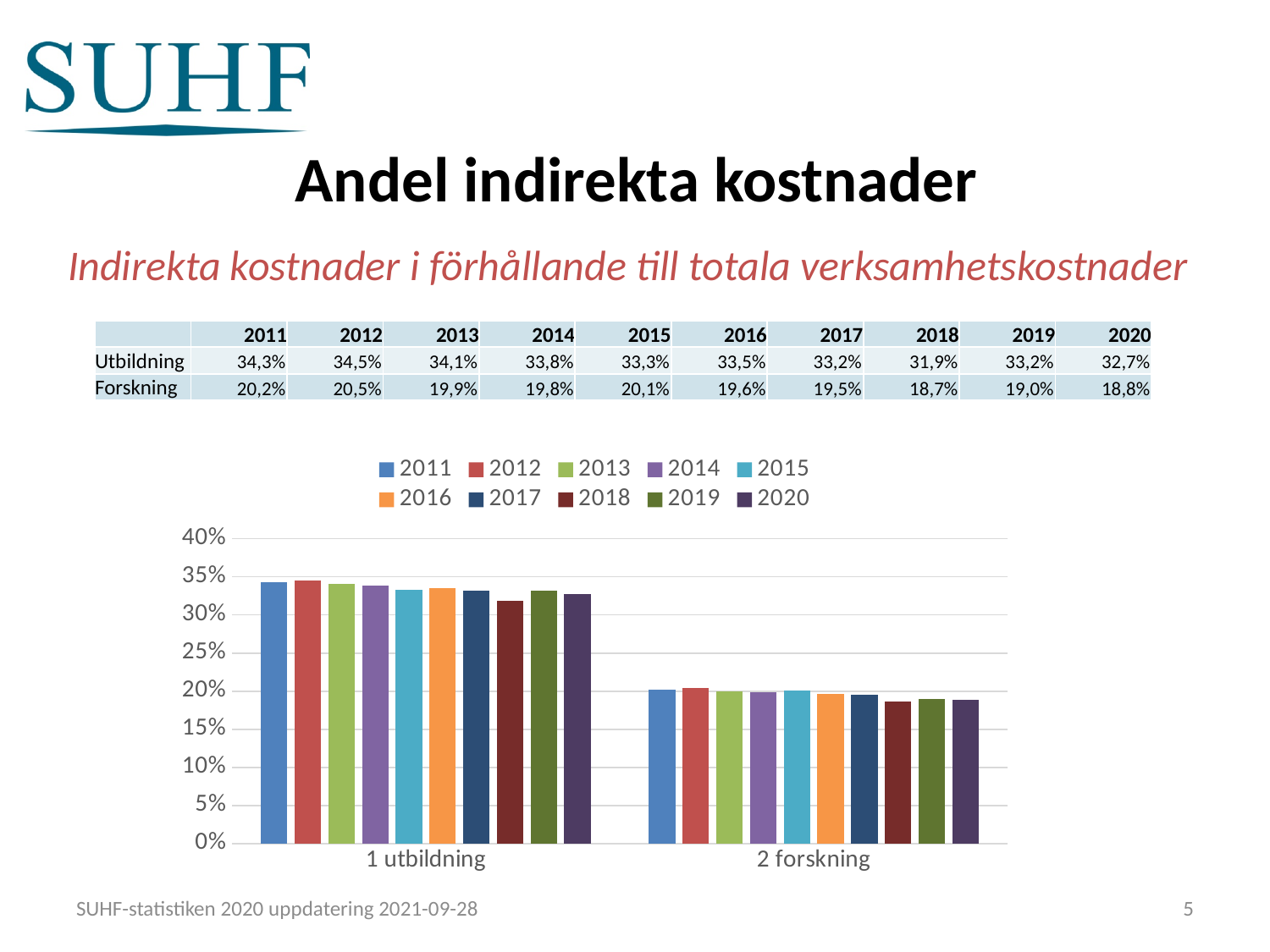
Do the Forskning values generally rise or fall from 2011 to 2020? fall Is the value for Forskning in 2018 greater or less than 20%? less What is the difference between the Utbildning and Forskning values in 2011? 14,1 percentage points What is the title of the slide containing the chart? Andel indirekta kostnader Which is larger, the Utbildning value in 2012 or the Utbildning value in 2018? 2012 How many categories are shown on the x axis of the chart? 2 Which year has the lowest value for Forskning? 2018 How many series does the chart legend list? 10 What is the value for Utbildning in 2011? 34,3% Which year has the highest value for Utbildning? 2012 What type of chart is shown on the slide? bar chart What is the value for Forskning in 2020? 18,8%